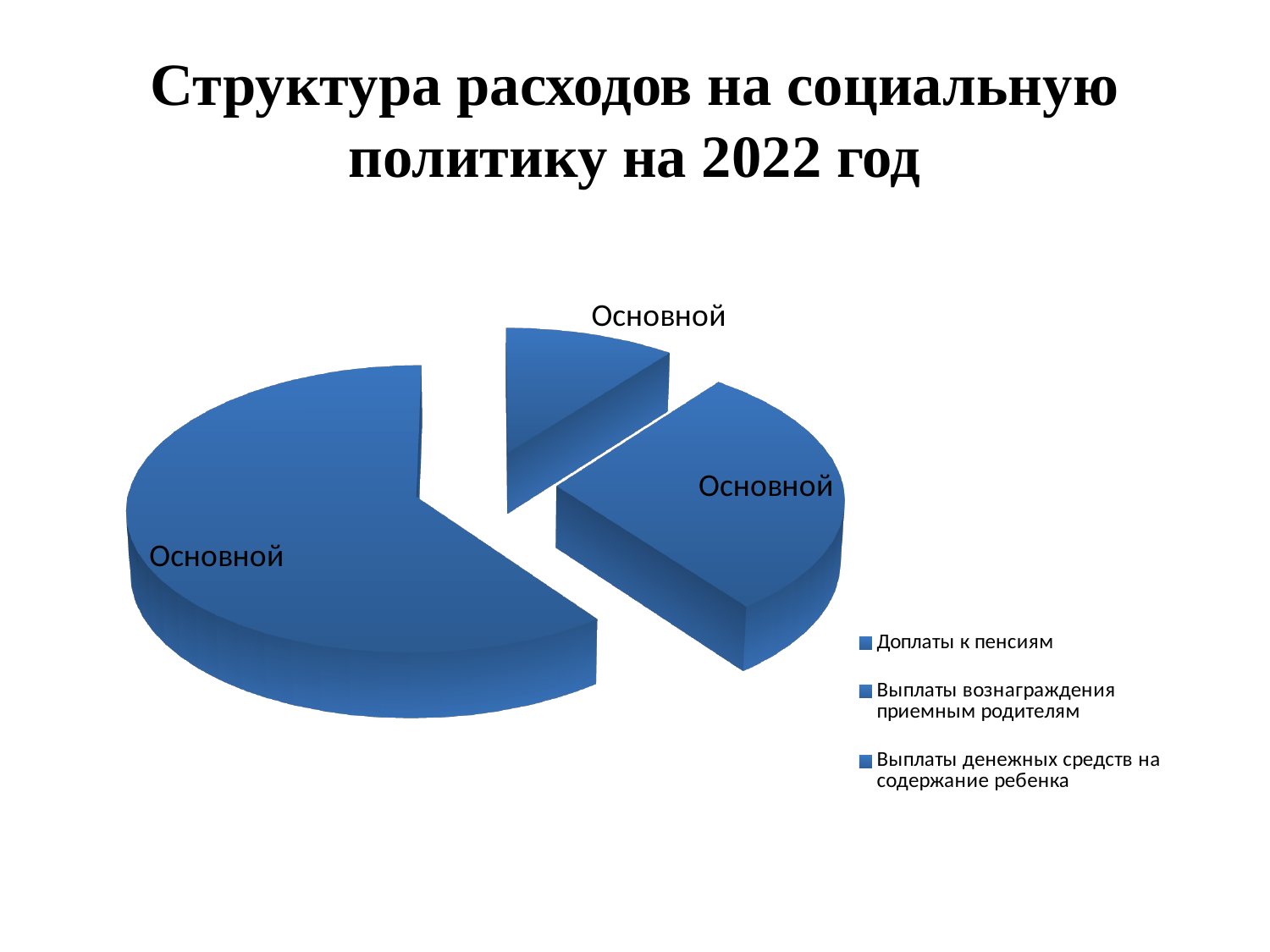
What is the first entry listed in the legend of the pie chart? Доплаты к пенсиям Does the largest slice of the pie chart take up more or less than half of the pie? more How many entries does the legend of the pie chart list? 3 What is the title of the slide containing the pie chart? Структура расходов на социальную политику на 2022 год What kind of chart is shown on the slide? Pie chart How many slices does the pie chart have? 3